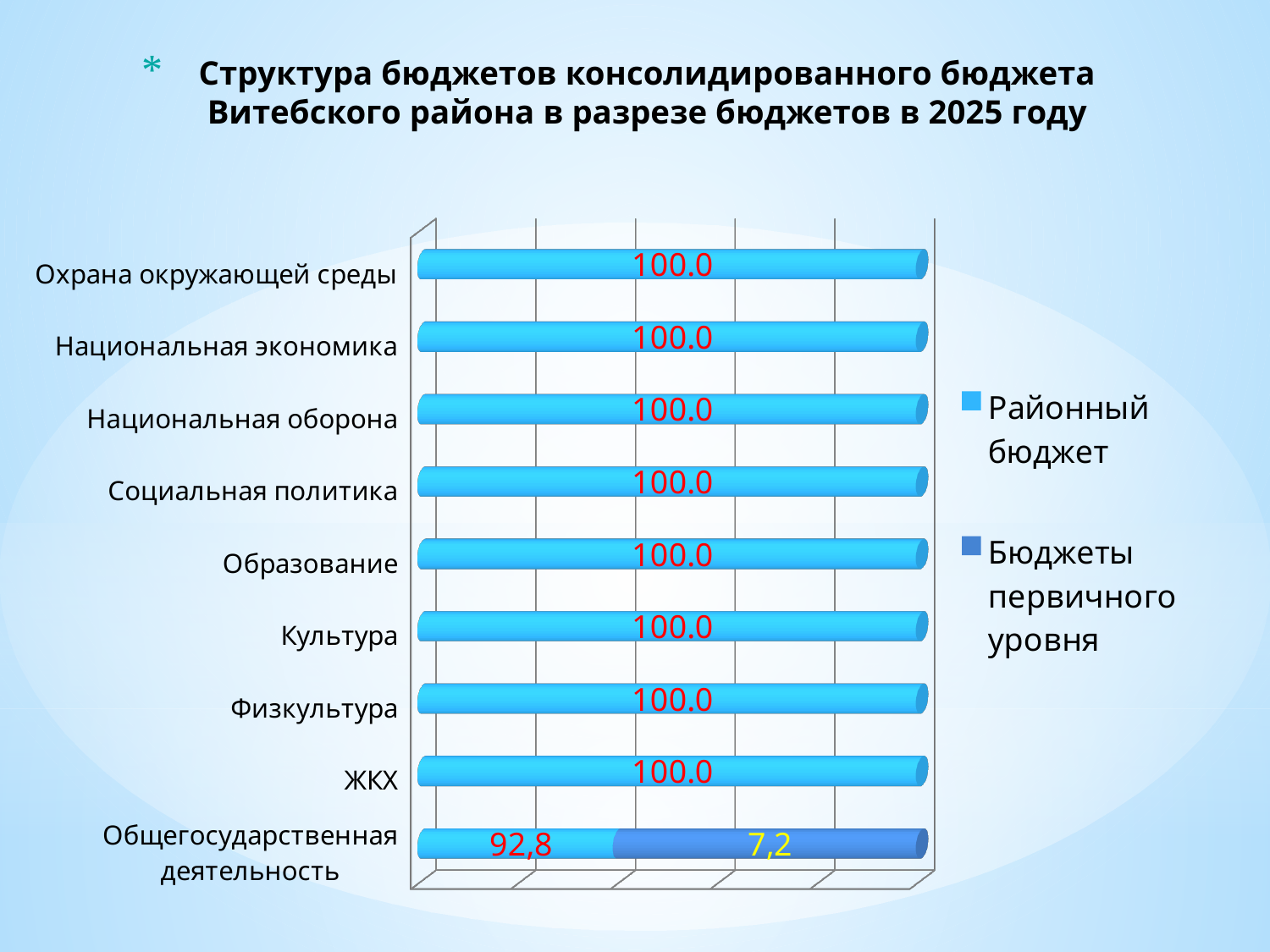
What is the value of Районный бюджет for Общегосударственная деятельность? 92,8 What is the value of Районный бюджет for ЖКХ? 100.0 What kind of chart is shown on the slide? bar chart How many series does the legend list? 2 What are the two legend entries of the chart? Районный бюджет; Бюджеты первичного уровня What is the value of Бюджеты первичного уровня for Общегосударственная деятельность? 7,2 What is the total of the stacked bar for Общегосударственная деятельность? 100 What is the difference between the Районный бюджет value for Культура and the Районный бюджет value for Общегосударственная деятельность? 7,2 How many categories are plotted on the chart? 9 Which category has the lowest value for Районный бюджет? Общегосударственная деятельность What is the value of Районный бюджет for Образование? 100.0 Which is larger for Общегосударственная деятельность: Районный бюджет or Бюджеты первичного уровня? Районный бюджет